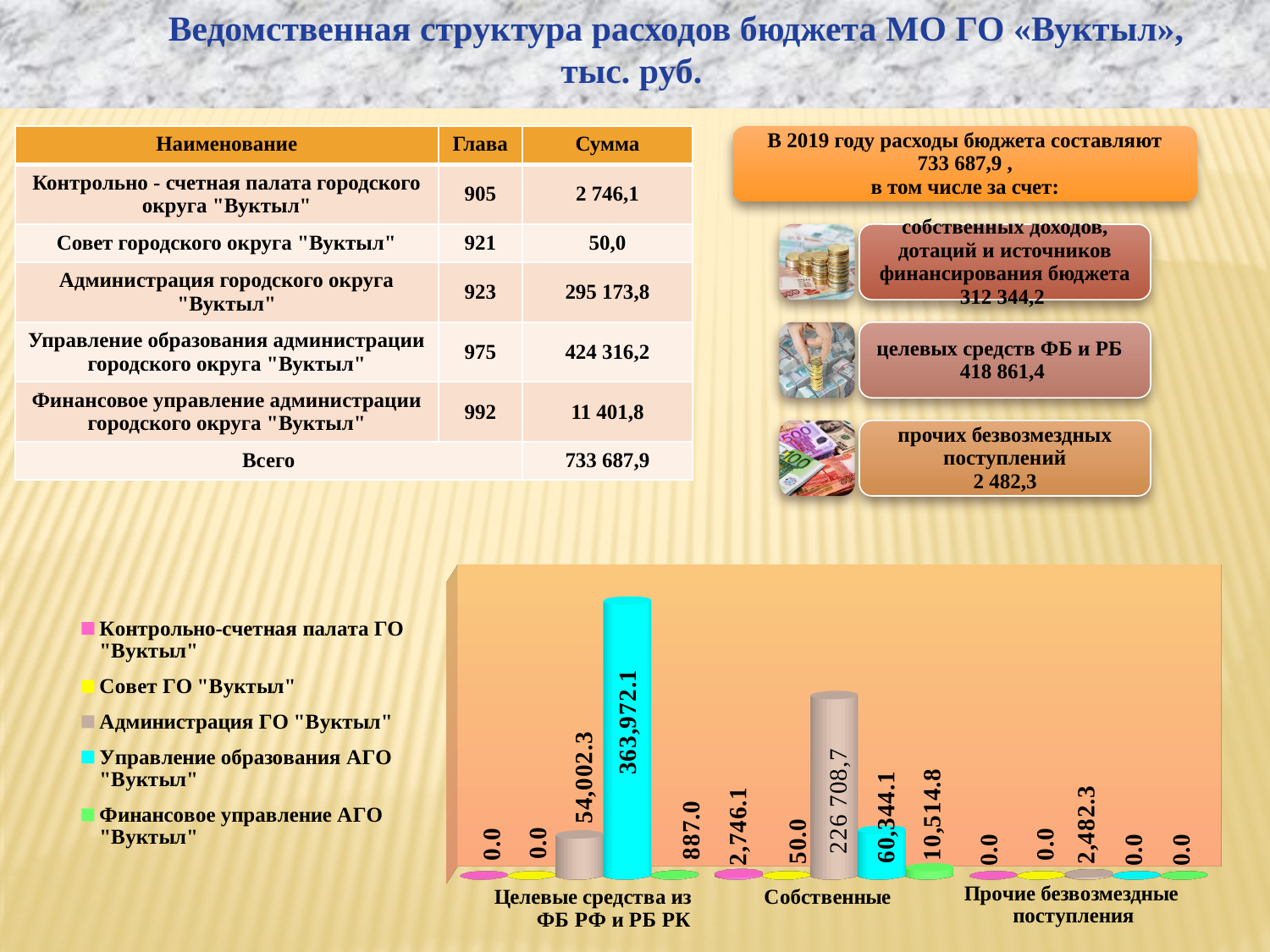
What is the value for Администрация ГО "Вуктыл" in the category Прочие безвозмездные поступления? 2,482.3 What is the value for Контрольно-счетная палата ГО "Вуктыл" in the category Собственные? 2,746.1 How many series does the chart legend list? 5 How many categories are shown along the x axis of the chart? 3 Which series has the highest value in the category Целевые средства из ФБ РФ и РБ РК? Управление образования АГО "Вуктыл" What is the value for Финансовое управление АГО "Вуктыл" in the category Собственные? 10,514.8 Which series has the highest value in the category Собственные? Администрация ГО "Вуктыл" Which is larger in the category Собственные: the value for Управление образования АГО "Вуктыл" or the value for Финансовое управление АГО "Вуктыл"? Управление образования АГО "Вуктыл" What kind of chart is shown on the slide? bar chart What is the value for Администрация ГО "Вуктыл" in the category Собственные? 226 708,7 What is the value for Управление образования АГО "Вуктыл" in the category Целевые средства из ФБ РФ и РБ РК? 363,972.1 What is the difference between the value for Управление образования АГО "Вуктыл" and the value for Администрация ГО "Вуктыл" in the category Целевые средства из ФБ РФ и РБ РК? 309,969.8